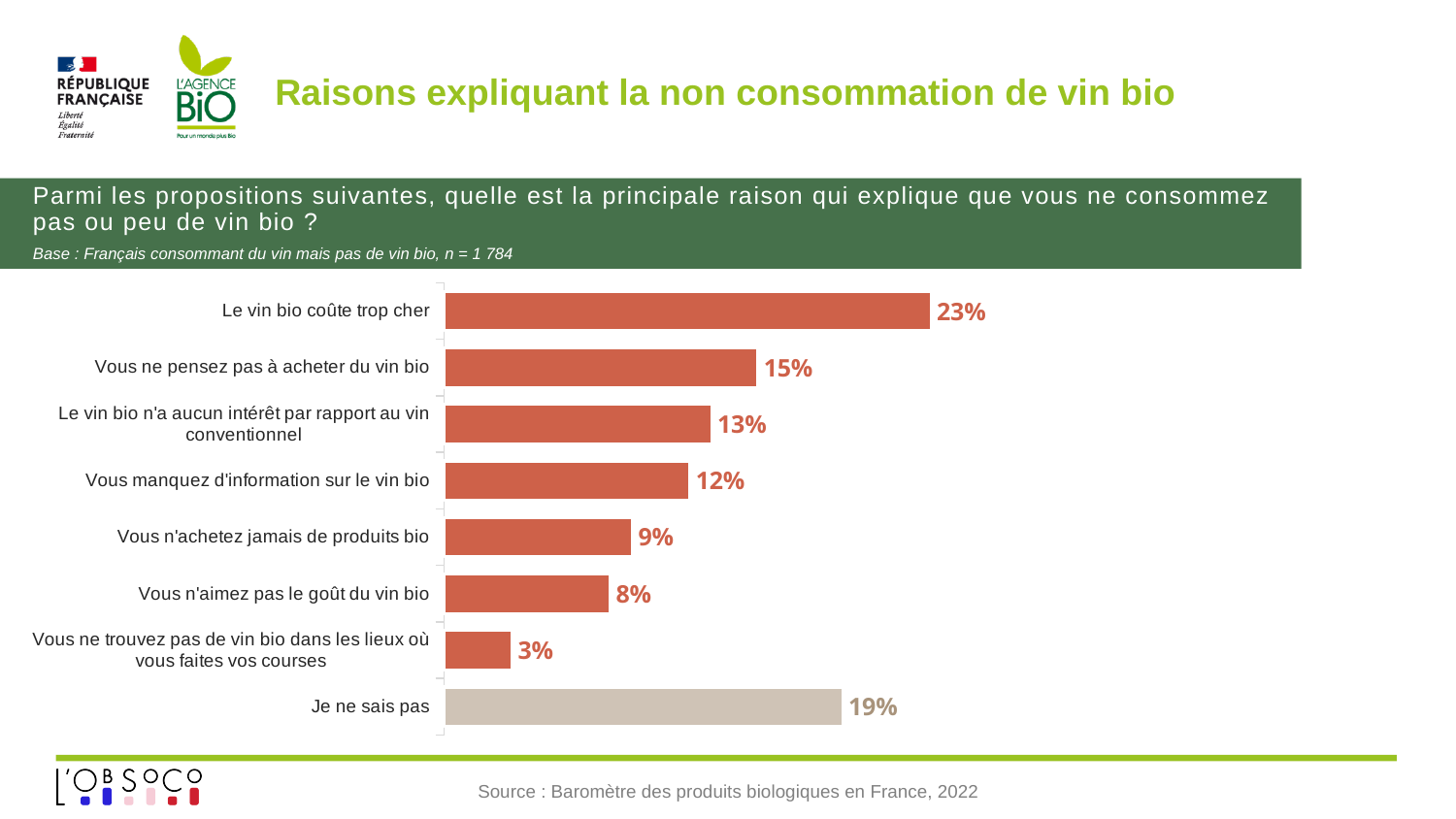
What kind of chart is shown on the slide? Bar chart What is the value for "Vous ne pensez pas à acheter du vin bio"? 15% Which category has the lowest percentage? Vous ne trouvez pas de vin bio dans les lieux où vous faites vos courses Which is larger: "Vous manquez d'information sur le vin bio" or "Vous n'achetez jamais de produits bio"? Vous manquez d'information sur le vin bio Which reason has the highest percentage? Le vin bio coûte trop cher What is the difference between "Le vin bio coûte trop cher" and "Vous ne pensez pas à acheter du vin bio"? 8 percentage points What is the value for "Je ne sais pas"? 19% Which bar is shown in a different colour (beige) from the others? Je ne sais pas What is the value for "Vous ne trouvez pas de vin bio dans les lieux où vous faites vos courses"? 3% How many categories are shown in the chart? 8 What is the difference between "Je ne sais pas" and "Vous n'aimez pas le goût du vin bio"? 11 percentage points What percentage of respondents say organic wine costs too much ("Le vin bio coûte trop cher")? 23%